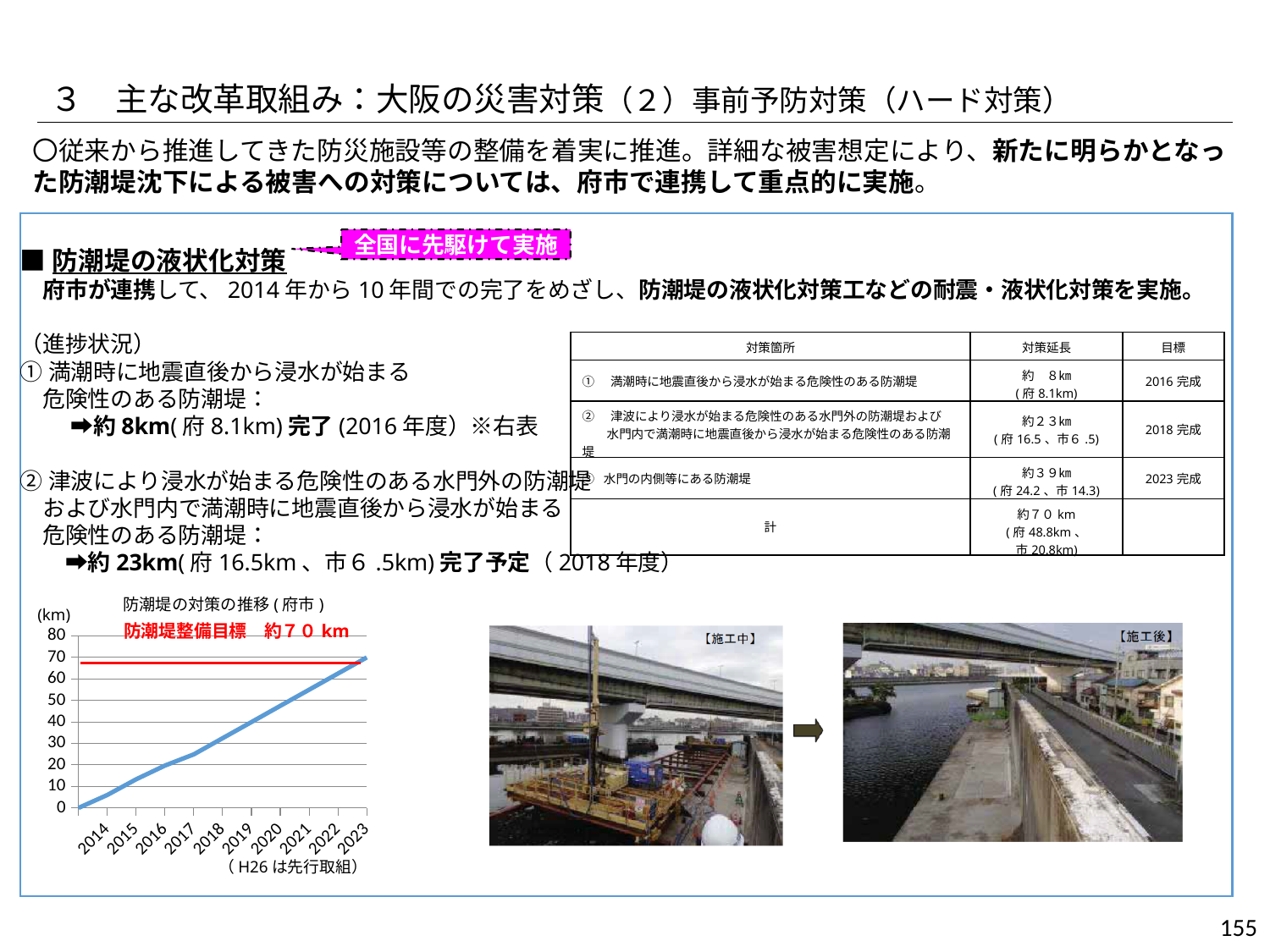
Is the value for 2020 greater or less than 40? greater How many years are plotted along the x axis of the chart? 10 Is the value for 2018 greater or less than 40? less Do the values in the chart rise or fall from 2014 to 2023? rise What is the title of the chart on the slide? 防潮堤の対策の推移(府市) Which year has the lowest value in the chart? 2014 Which year has the highest value in the chart? 2023 Is the value for 2022 greater or less than 50? greater What kind of chart is shown on the slide? line chart What target value does the red horizontal line in the chart represent? 約70 km